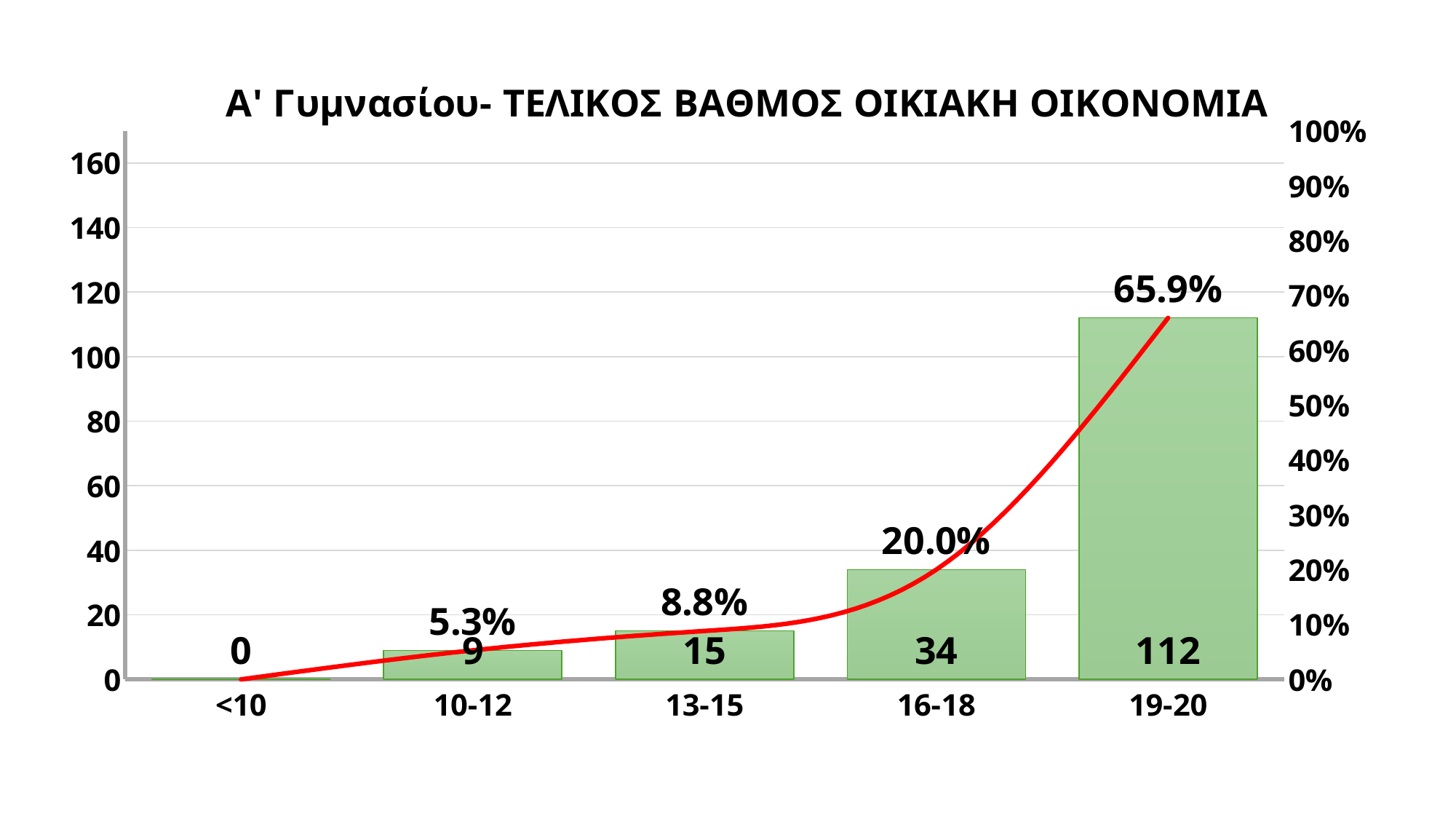
What is the title of the chart? Α' Γυμνασίου- ΤΕΛΙΚΟΣ ΒΑΘΜΟΣ ΟΙΚΙΑΚΗ ΟΙΚΟΝΟΜΙΑ Which grade band has the highest number of students? 19-20 What is the number of students in the 16-18 grade band? 34 What percentage is shown for the 10-12 grade band? 5.3% Do the bar values rise or fall from left to right along the x axis? rise Which grade band has more students, 10-12 or 13-15? 13-15 What percentage is shown for the 13-15 grade band? 8.8% What is the difference in the number of students between the 19-20 and 16-18 grade bands? 78 What colour is the line plotted over the bars? red What is the number of students in the 19-20 grade band? 112 How many grade bands are shown on the x axis? 5 Which grade band has the lowest number of students? <10